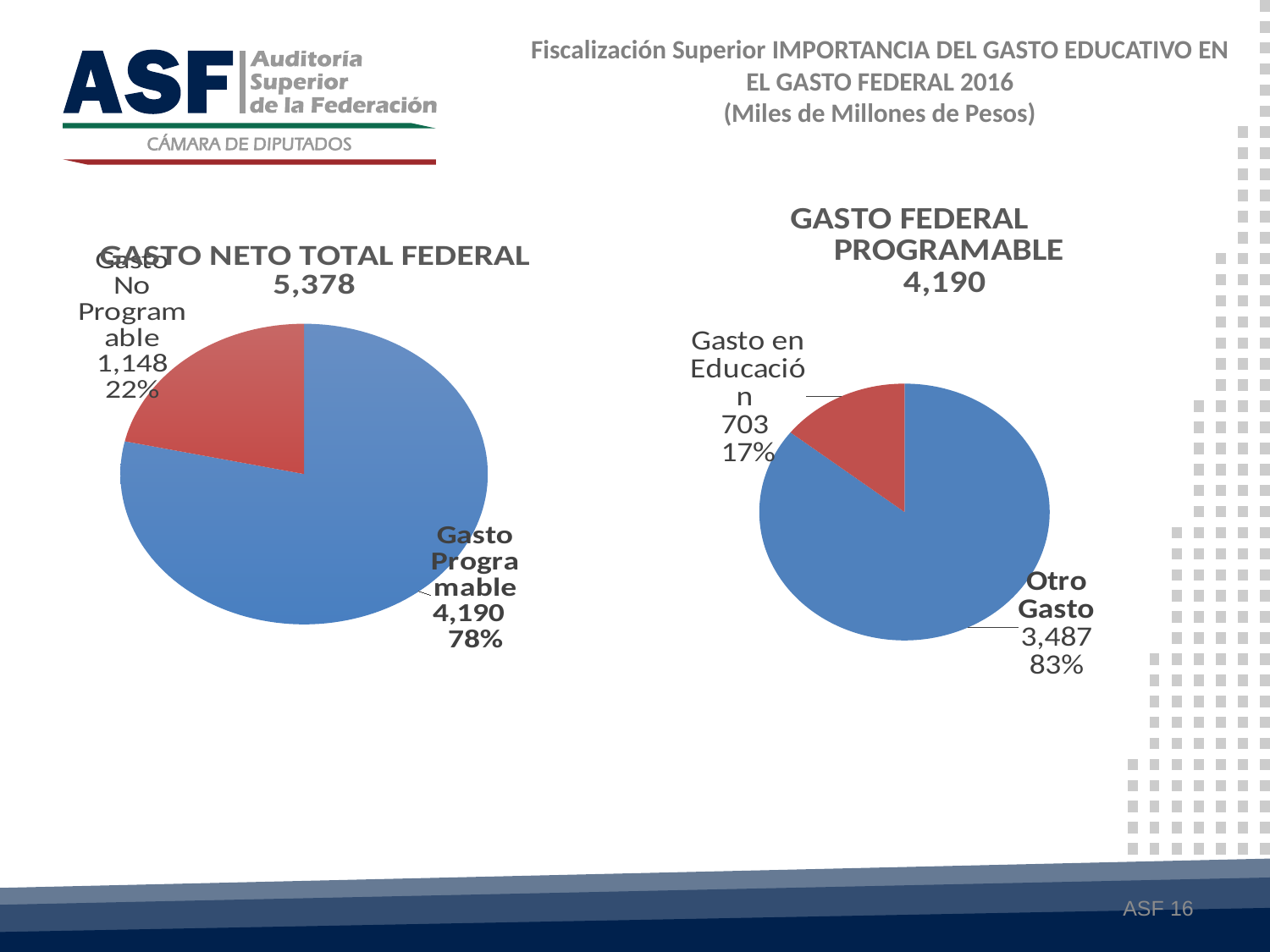
In the 'GASTO NETO TOTAL FEDERAL 5,378' pie chart, which slice is the largest? Gasto Programable In the 'GASTO FEDERAL PROGRAMABLE 4,190' pie chart, what is the value for Otro Gasto? 3,487 What kind of chart is the 'GASTO NETO TOTAL FEDERAL 5,378' chart? Pie chart In the 'GASTO NETO TOTAL FEDERAL 5,378' pie chart, what is the difference between Gasto Programable and Gasto No Programable? 3,042 In the 'GASTO NETO TOTAL FEDERAL 5,378' pie chart, what share of the pie is Gasto No Programable? 22% In the 'GASTO FEDERAL PROGRAMABLE 4,190' pie chart, which slice is the smallest? Gasto en Educación In the 'GASTO FEDERAL PROGRAMABLE 4,190' pie chart, what is the value for Gasto en Educación? 703 In the 'GASTO NETO TOTAL FEDERAL 5,378' pie chart, what is the value for Gasto Programable? 4,190 In the 'GASTO FEDERAL PROGRAMABLE 4,190' pie chart, how many slices does the pie have? 2 In the 'GASTO NETO TOTAL FEDERAL 5,378' pie chart, what share of the pie is Gasto Programable? 78% In the 'GASTO FEDERAL PROGRAMABLE 4,190' pie chart, what share of the pie is Gasto en Educación? 17% In the 'GASTO NETO TOTAL FEDERAL 5,378' pie chart, what is the value for Gasto No Programable? 1,148